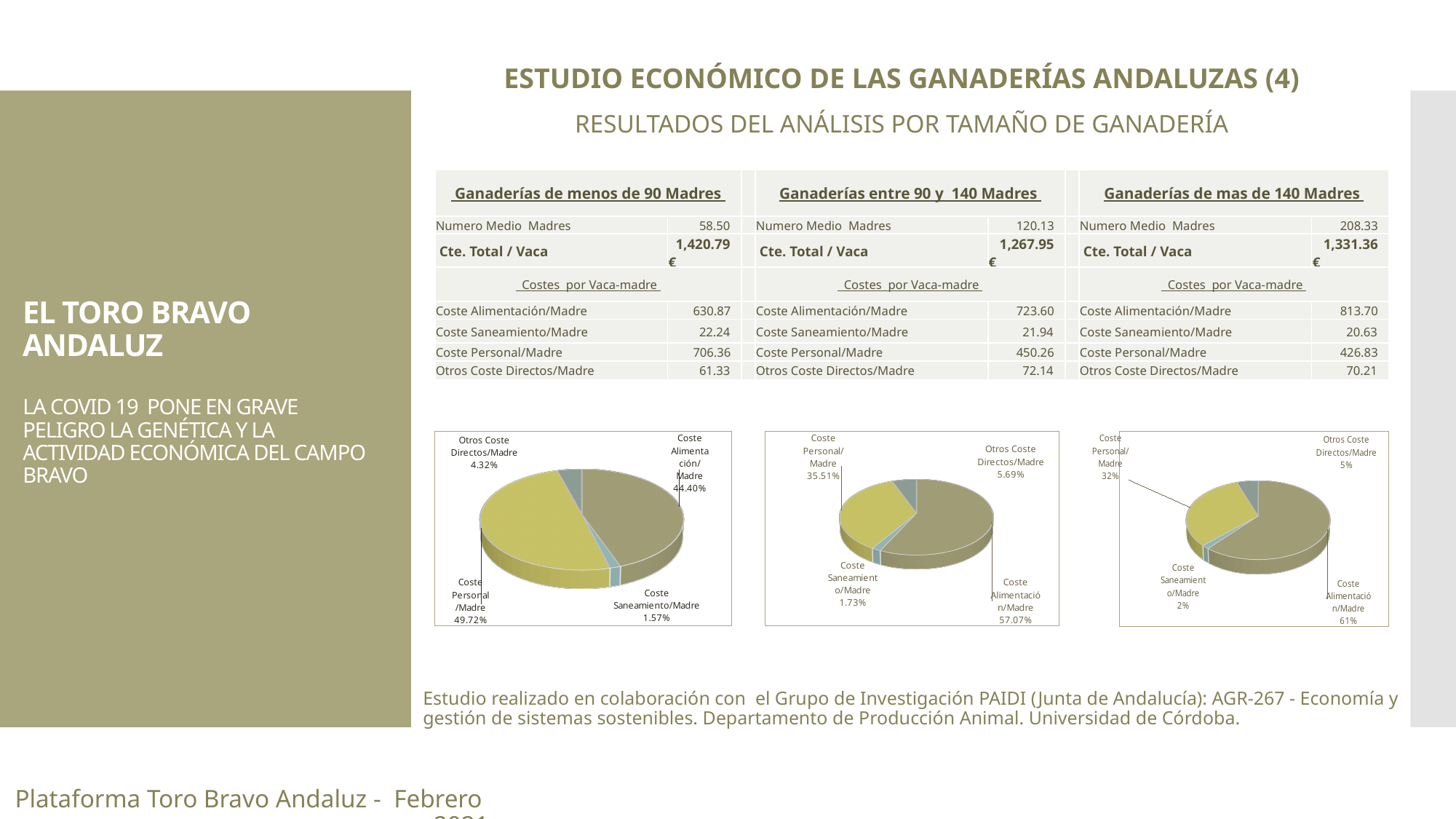
In the right-hand pie chart, what share does Coste Personal/Madre have? 32% In the middle pie chart, which is larger: Coste Personal/Madre or Otros Coste Directos/Madre? Coste Personal/Madre In the middle pie chart, what share does Otros Coste Directos/Madre have? 5.69% In the right-hand pie chart, what share does Coste Alimentación/Madre have? 61% In the middle pie chart, which slice is the largest? Coste Alimentación/Madre How many slices does the right-hand pie chart have? 4 In the left-hand pie chart, what is the difference between the Coste Personal/Madre share and the Coste Alimentación/Madre share? 5.32% What kind of chart is the left-hand chart on the slide? pie chart In the left-hand pie chart, which slice is the smallest? Coste Saneamiento/Madre